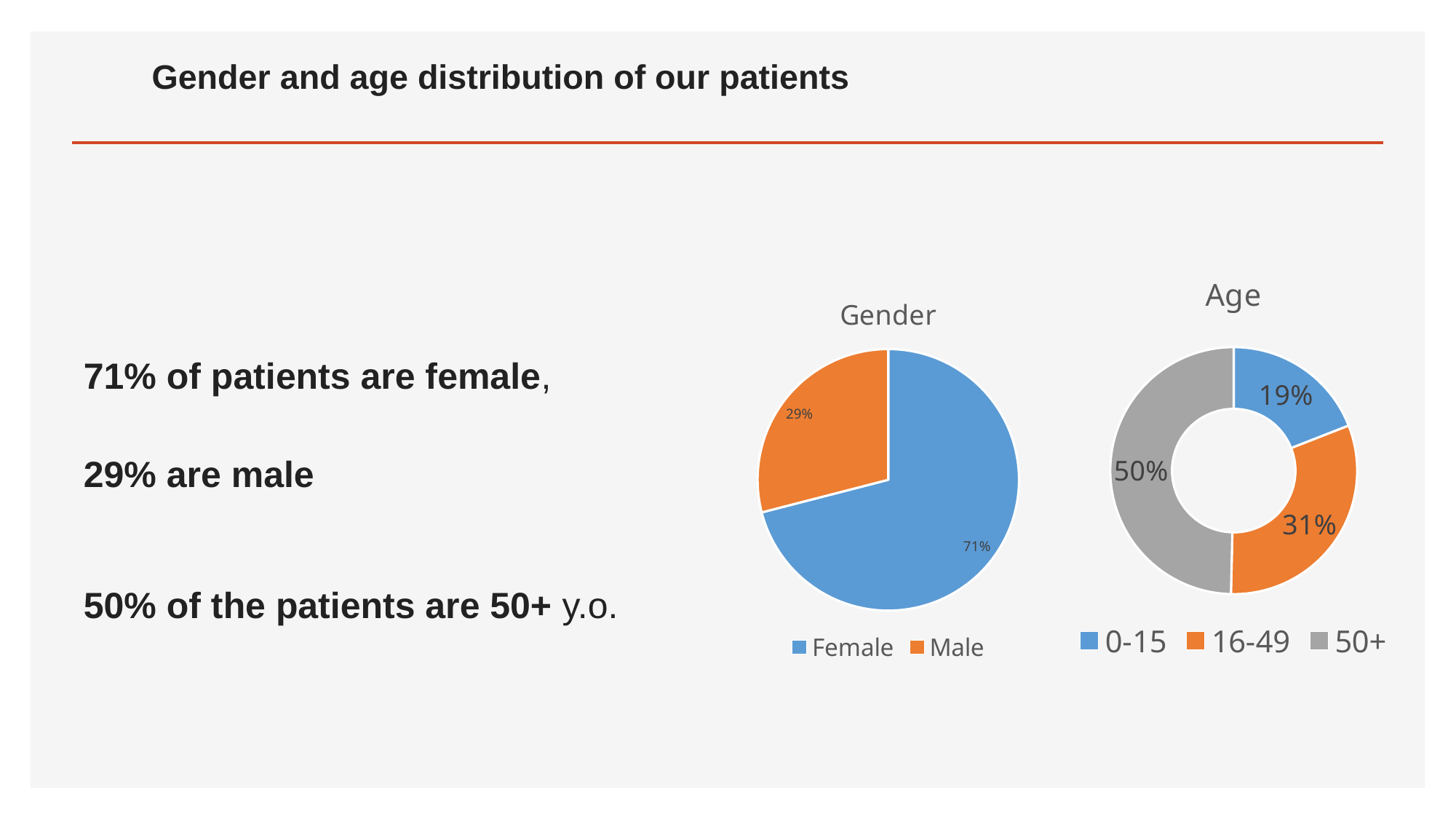
What kind of chart is the Gender chart? Pie chart In the Age chart, what share of patients are aged 50+? 50% In the Gender chart, what is the difference in percentage points between female and male patients? 42 In the Gender chart, what percentage of patients are male? 29% In the Age chart, which age group has the largest share? 50+ In the Age chart, what share of patients are aged 0-15? 19% How many categories does the Age chart's legend list? 3 In the Age chart, which is larger, the 16-49 share or the 0-15 share? 16-49 In the Gender chart, what percentage of patients are female? 71% In the Age chart, which age group has the smallest share? 0-15 In the Age chart, what is the difference in percentage points between the 50+ and 16-49 groups? 19 In the Age chart, what share of patients are aged 16-49? 31%